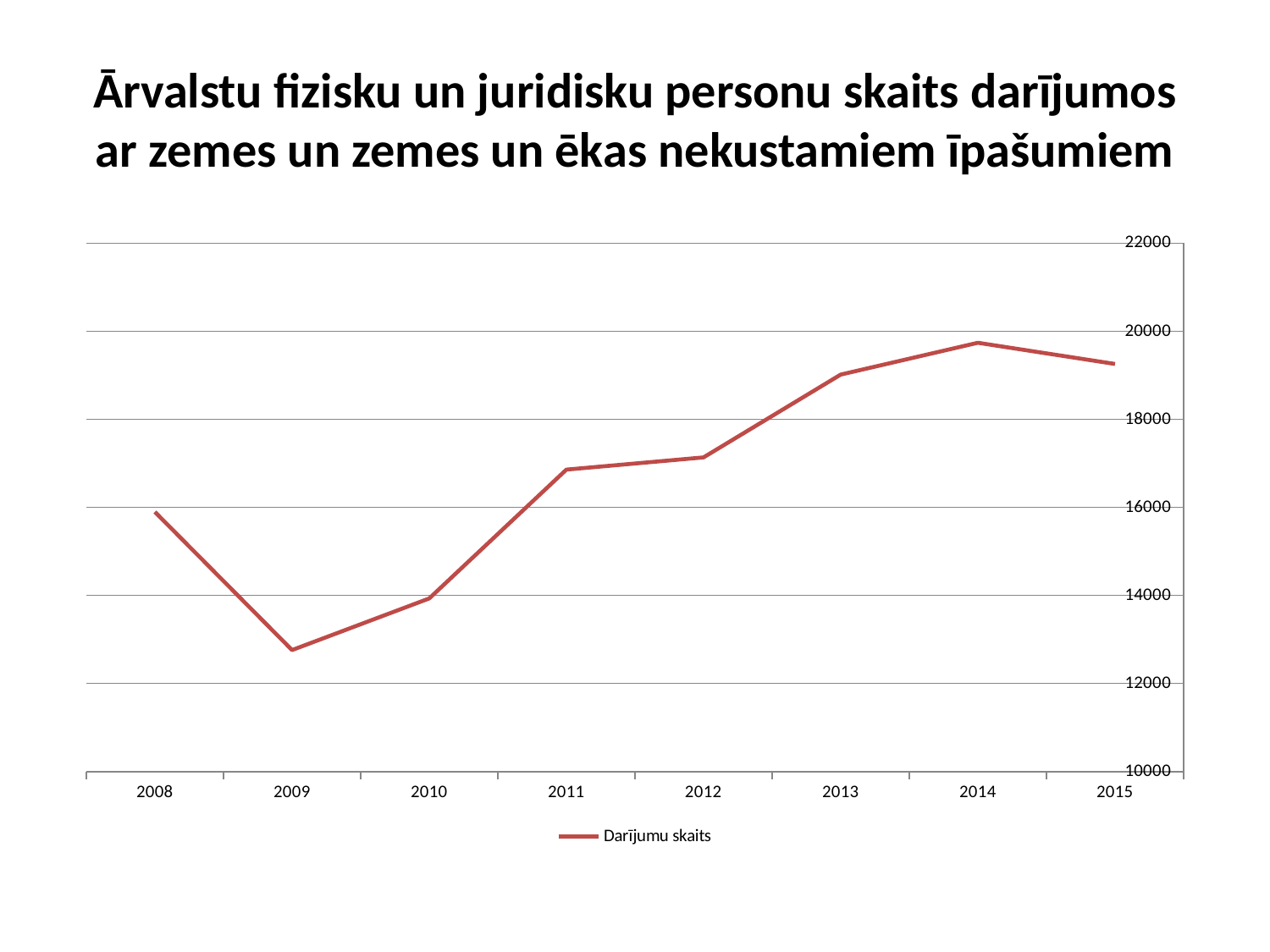
Is the value for 2013 greater or less than 18000? greater In which year is the value of Darījumu skaits lowest? 2009 Which year has the larger value, 2010 or 2013? 2013 Is the value for 2011 greater or less than 16000? greater In which year is the value of Darījumu skaits highest? 2014 Is the value for 2014 greater or less than 20000? less How many years are plotted on the x axis? 8 What kind of chart is shown on the slide? line chart How many series does the legend list? 1 Does the value rise or fall from 2009 to 2014? rise What is the name of the series shown in the legend? Darījumu skaits